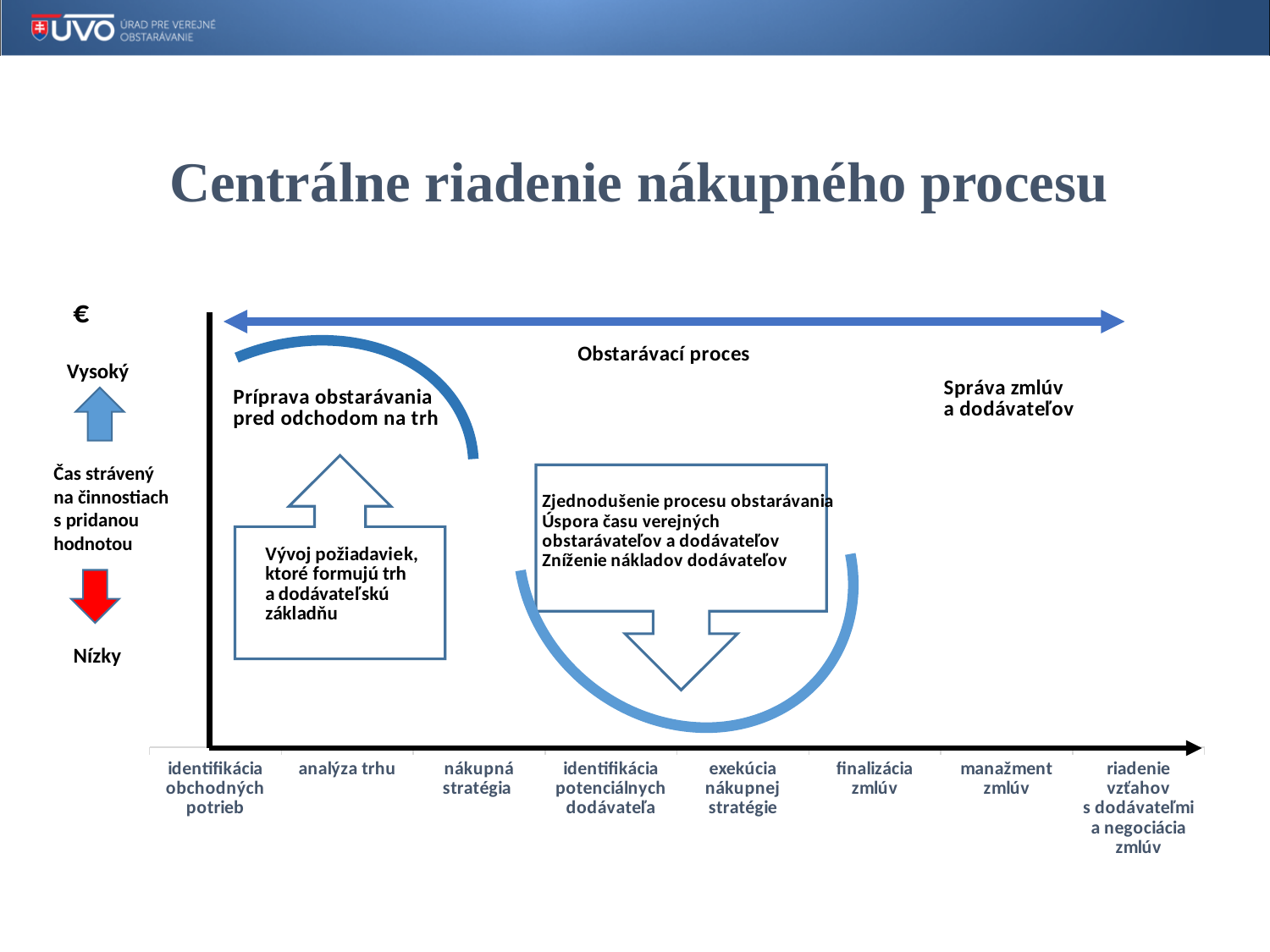
What is the last stage labelled on the horizontal axis of the diagram? riadenie vzťahov s dodávateľmi a negociácia zmlúv What label is written along the horizontal arrow at the top of the diagram? Obstarávací proces What is the title of the slide containing the diagram? Centrálne riadenie nákupného procesu How many stages are labelled along the horizontal axis of the diagram? 8 What is the first stage labelled on the horizontal axis of the diagram? identifikácia obchodných potrieb